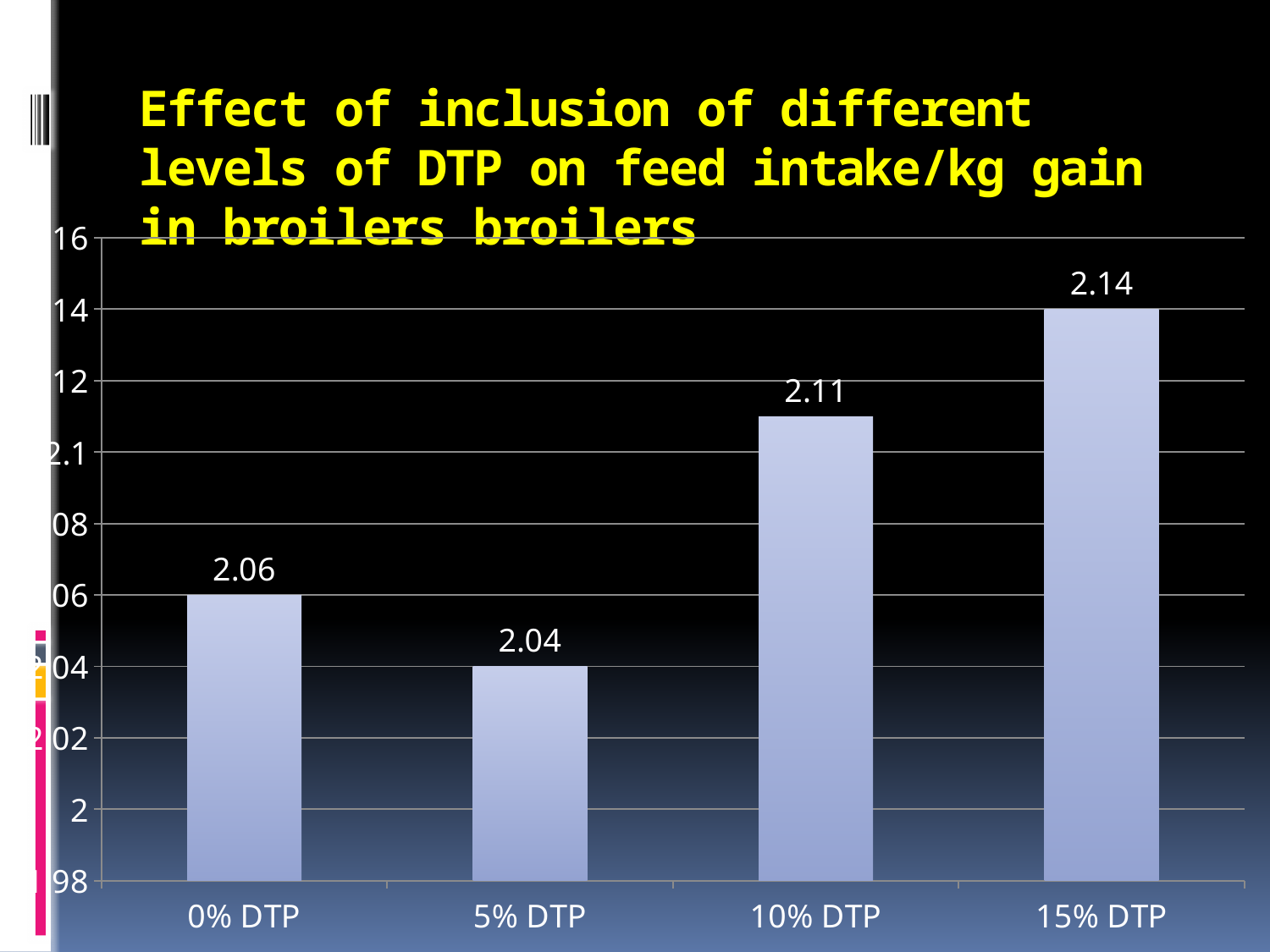
What is the feed intake/kg gain value for 10% DTP? 2.11 Is the value for 15% DTP greater or less than 2.1? greater What is the difference between the values for 10% DTP and 0% DTP? 0.05 Which DTP level has the highest feed intake/kg gain? 15% DTP Which is larger, the value for 0% DTP or the value for 5% DTP? 0% DTP How many DTP levels are shown on the chart? 4 What is the title of the chart? Effect of inclusion of different levels of DTP on feed intake/kg gain in broilers broilers What is the value shown for 5% DTP? 2.04 Which DTP level has the lowest feed intake/kg gain? 5% DTP What is the value shown for 0% DTP? 2.06 What kind of chart is shown on the slide? Bar chart What is the difference between the values for 15% DTP and 5% DTP? 0.1